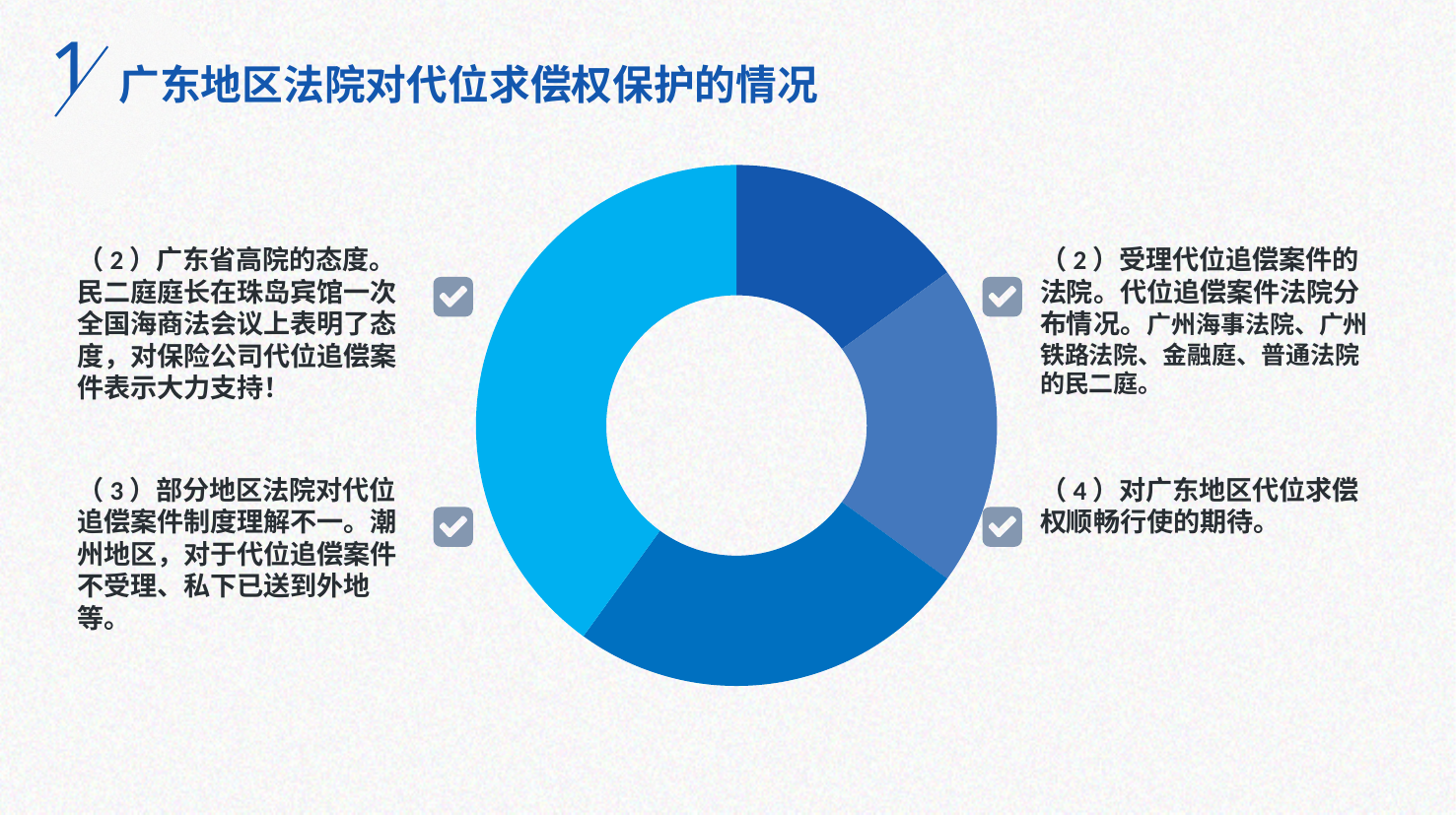
Does the donut chart display any data labels or percentage values on its segments? No Which is larger in the donut chart: the light blue segment on the left or the dark blue segment at the top right? The light blue segment on the left How many segments does the donut chart have? 4 What kind of chart is shown on the slide? Donut (pie) chart Which segment of the donut chart is the largest? The light blue segment on the left What is the title of the slide containing the donut chart? 广东地区法院对代位求偿权保护的情况